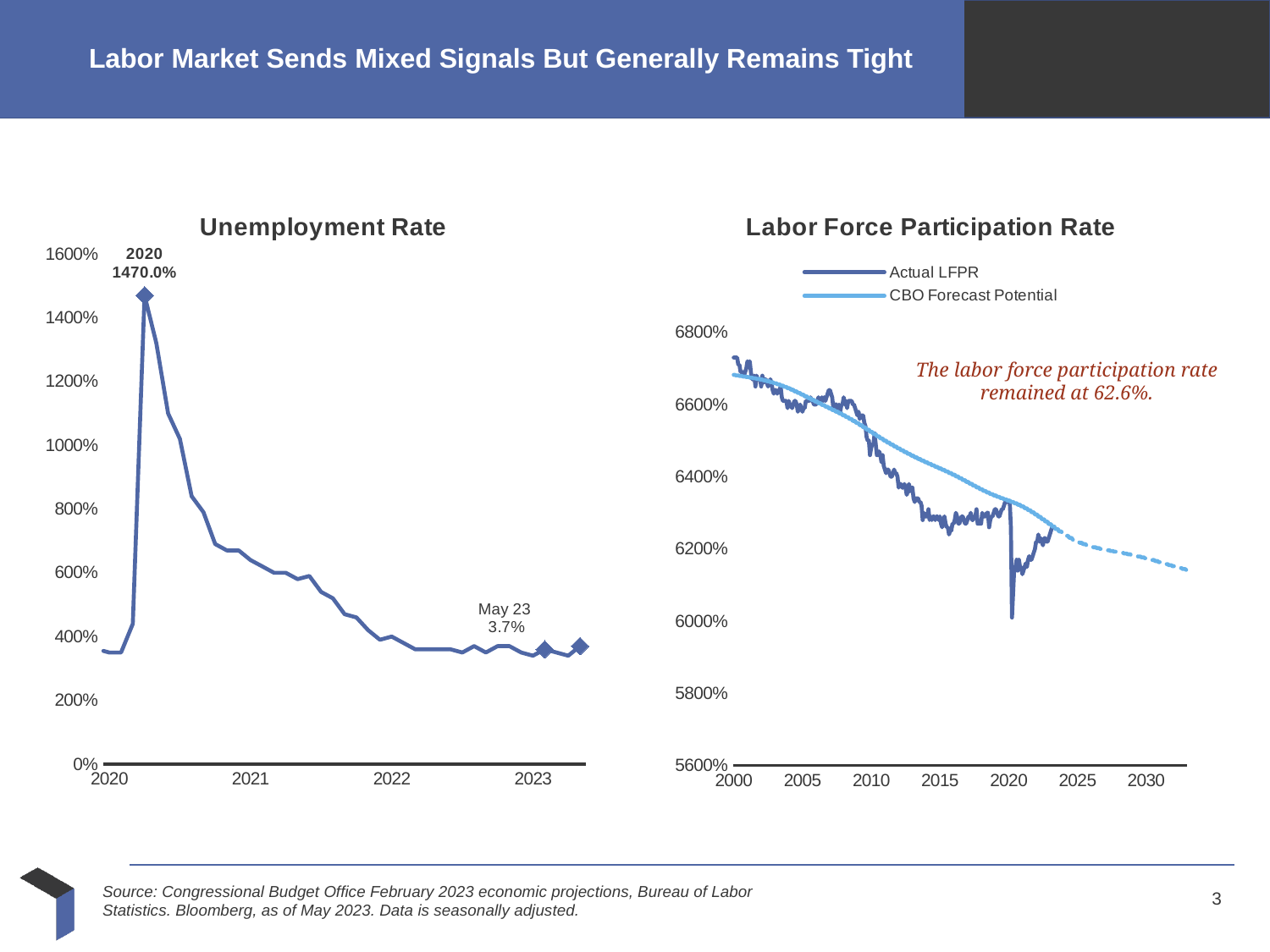
What kind of chart is the Unemployment Rate chart? line chart On the Unemployment Rate chart, what value is labeled for May 23? 3.7% On the Unemployment Rate chart, is the value at the start of 2020 greater or less than 400%? less On the Labor Force Participation Rate chart, is the Actual LFPR value in 2000 greater or less than 6600%? greater On the Labor Force Participation Rate chart, does the CBO Forecast Potential line rise or fall from 2000 to 2030? fall According to the annotation on the Labor Force Participation Rate chart, at what level did the labor force participation rate remain? 62.6% On the Labor Force Participation Rate chart, is the CBO Forecast Potential value at 2030 greater or less than 6200%? less How many series does the legend of the Labor Force Participation Rate chart list? 2 On the Unemployment Rate chart, which labeled point is higher, the 2020 peak or May 23? 2020 peak On the Unemployment Rate chart, what value is labeled at the 2020 peak? 1470.0% What are the two legend entries on the Labor Force Participation Rate chart? Actual LFPR and CBO Forecast Potential On the Unemployment Rate chart, does the line rise or fall from the 2020 peak to 2023? fall